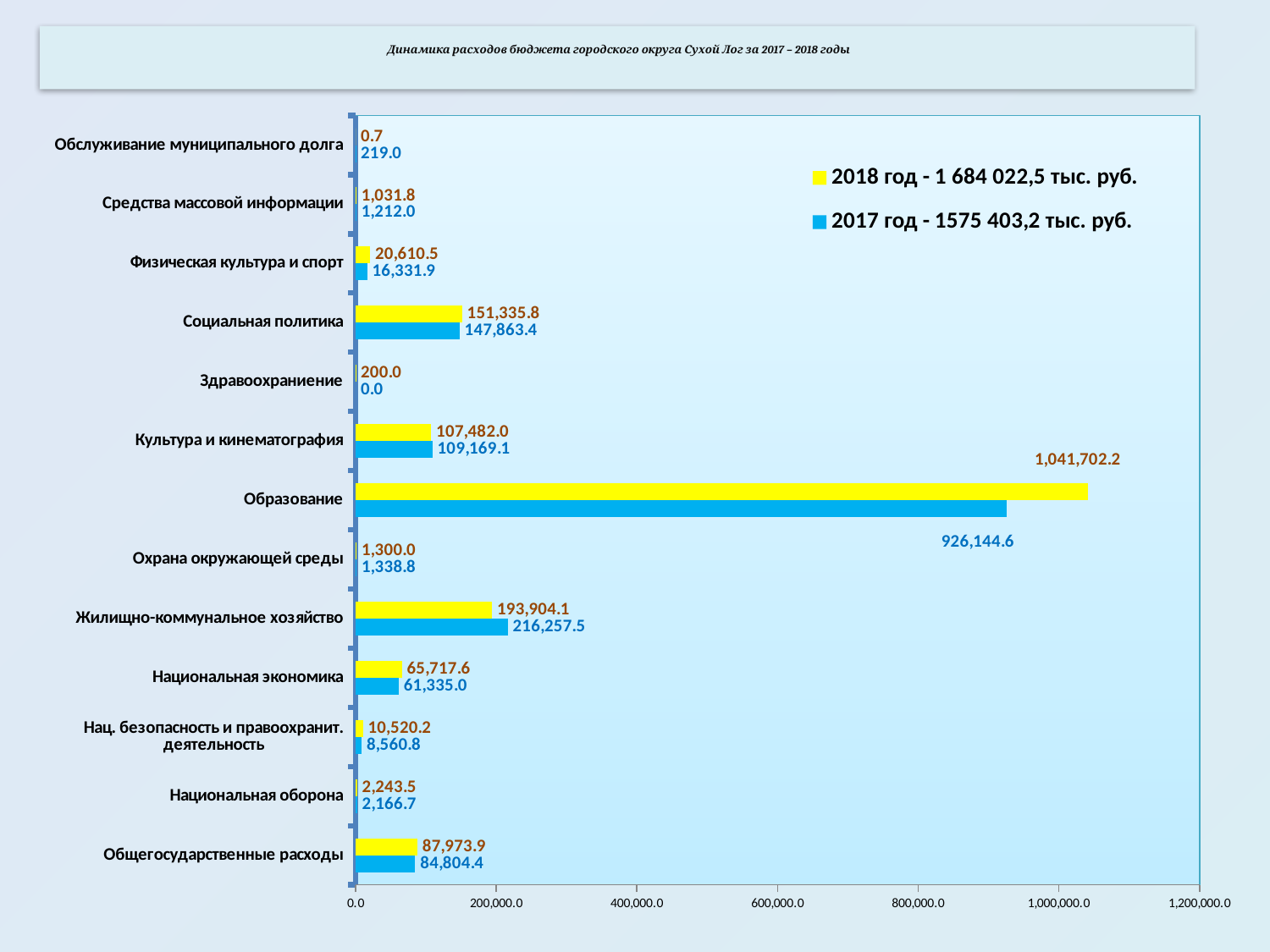
What is the 2018 value for Образование? 1,041,702.2 Which category has the lowest 2018 value? Обслуживание муниципального долга Which category has the highest 2017 value? Образование How many categories are shown on the chart? 13 Which colour represents the 2018 series in the legend? yellow What is the 2017 value for Здравоохранение? 0.0 What is the 2017 value for Жилищно-коммунальное хозяйство? 216,257.5 What type of chart is shown on the slide? bar chart Which is larger for Жилищно-коммунальное хозяйство: the 2018 value or the 2017 value? 2017 What is the 2018 value for Социальная политика? 151,335.8 How many series does the legend list? 2 What is the difference between the 2018 and 2017 values for Образование? 115,557.6